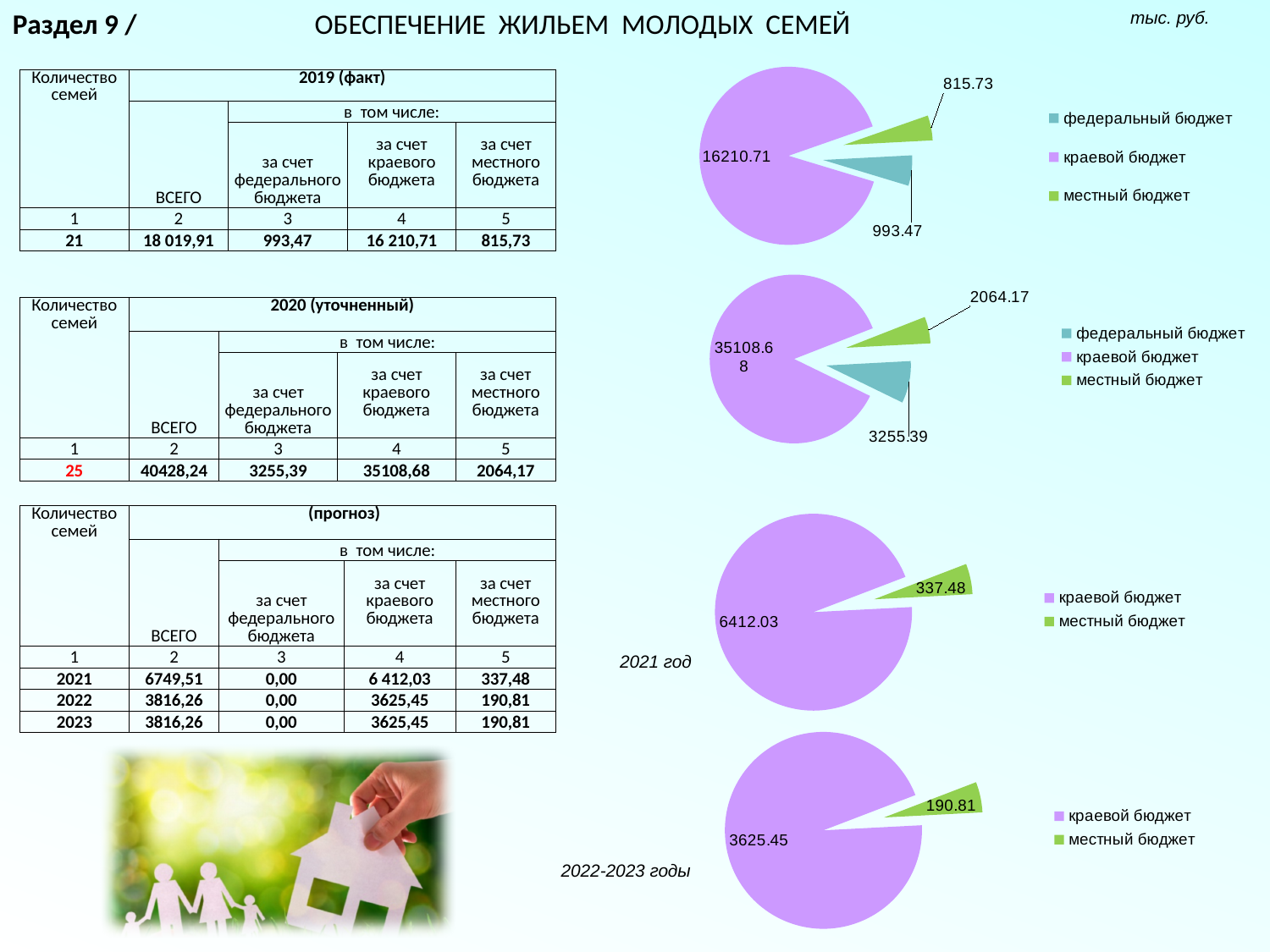
How many series does the legend of the top pie chart list? 3 In the pie chart labelled 2022-2023 годы, what is the value of the краевой бюджет slice? 3625.45 In the pie chart labelled 2022-2023 годы, what is the difference between the краевой бюджет and местный бюджет slices? 3434.64 In the second pie chart from the top, what is the value of the местный бюджет slice? 2064.17 In the top pie chart, which slice is the smallest? местный бюджет In the top pie chart, what is the value of the краевой бюджет slice? 16210.71 What type of chart is used on the right side of the slide? Pie chart In the top pie chart, what is the value of the федеральный бюджет slice? 993.47 In the second pie chart from the top, which is larger: the федеральный бюджет slice or the местный бюджет slice? федеральный бюджет In the second pie chart from the top, which slice is the largest? краевой бюджет In the pie chart labelled 2021 год, what is the value of the местный бюджет slice? 337.48 How many slices does the pie chart labelled 2021 год have? 2